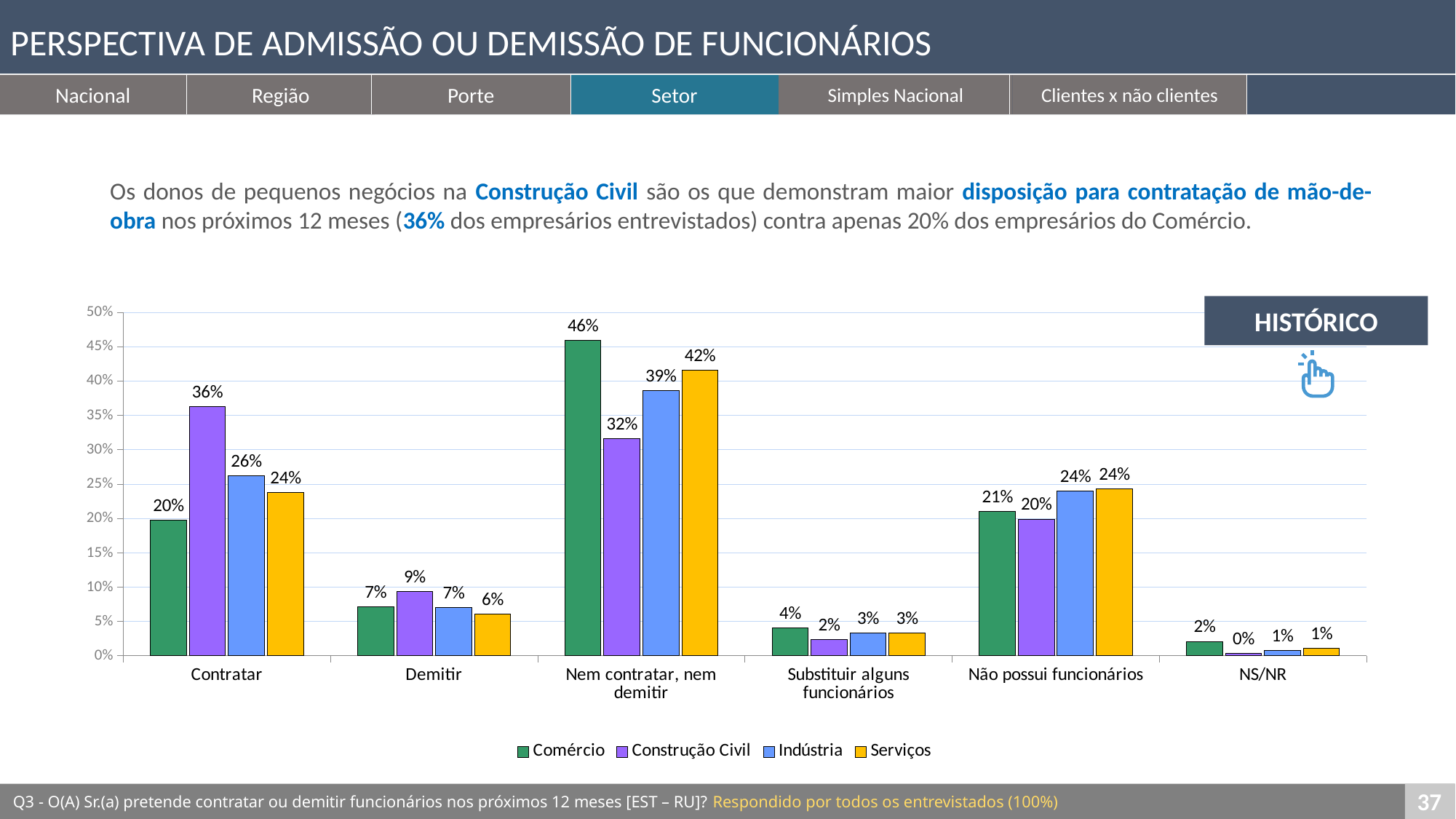
What is the value for Construção Civil in the Contratar category? 36% What kind of chart is shown on the slide? Bar chart What is the value for Indústria in the Não possui funcionários category? 24% Which series has the highest value in the Contratar category? Construção Civil How many categories are shown on the x axis? 6 Which series is shown in yellow in the legend? Serviços What is the difference between Comércio and Construção Civil in the Nem contratar, nem demitir category? 14% What is the value for Comércio in the Nem contratar, nem demitir category? 46% How many series does the legend list? 4 Which series has the lowest value in the NS/NR category? Construção Civil What is the value for Serviços in the Demitir category? 6% Which is larger in the Substituir alguns funcionários category: Comércio or Construção Civil? Comércio